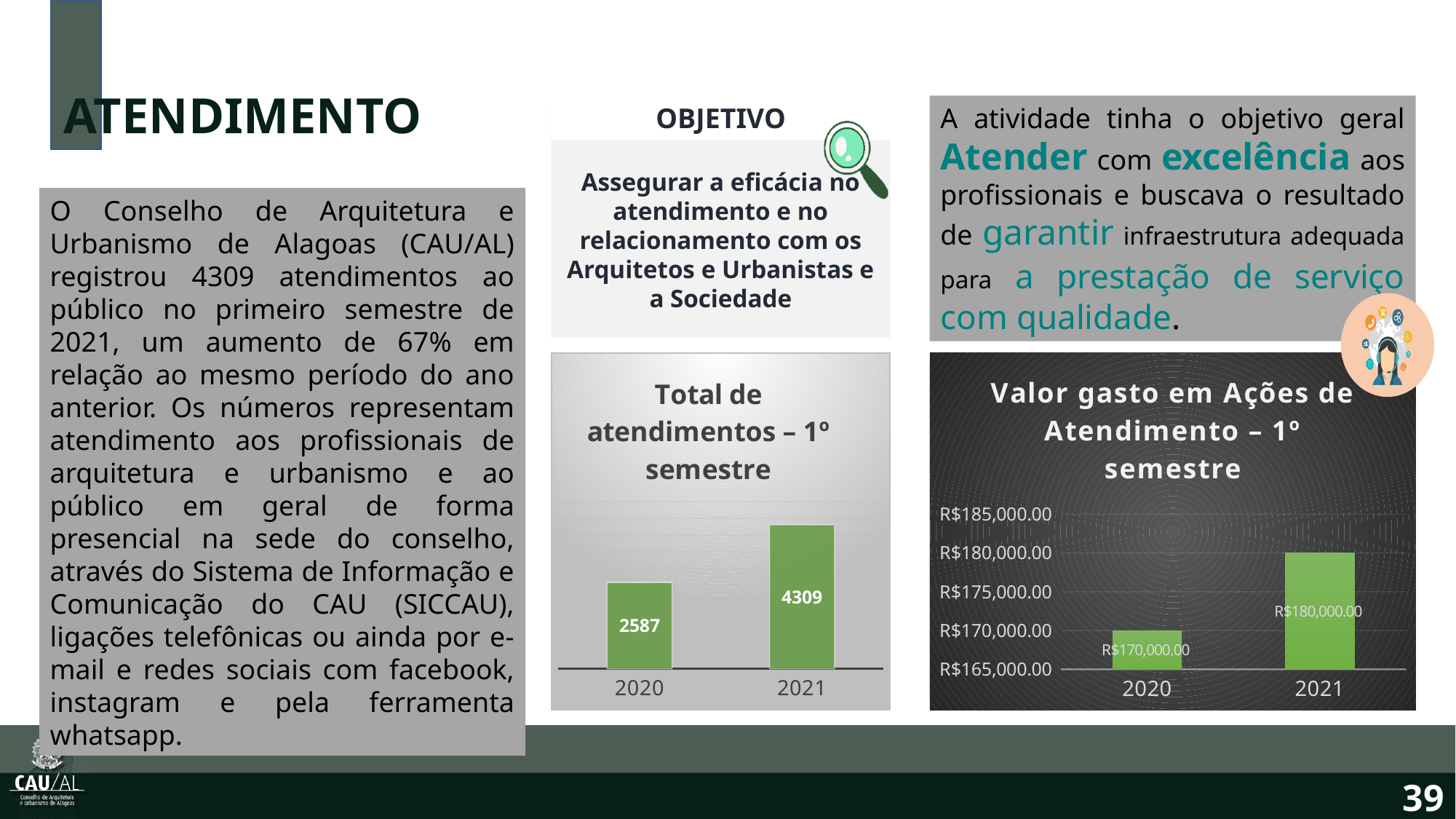
What kind of chart is 'Total de atendimentos – 1º semestre'? bar chart In the 'Total de atendimentos – 1º semestre' chart, how many categories are shown on the x axis? 2 In the 'Valor gasto em Ações de Atendimento – 1º semestre' chart, what is the value for 2020? R$170,000.00 In the 'Valor gasto em Ações de Atendimento – 1º semestre' chart, which year has the lower value? 2020 In the 'Valor gasto em Ações de Atendimento – 1º semestre' chart, do the values rise or fall from 2020 to 2021? rise In the 'Total de atendimentos – 1º semestre' chart, what is the value for 2020? 2587 In the 'Valor gasto em Ações de Atendimento – 1º semestre' chart, what is the value for 2021? R$180,000.00 In the 'Total de atendimentos – 1º semestre' chart, what is the value for 2021? 4309 What is the title of the chart on the dark background at the right of the slide? Valor gasto em Ações de Atendimento – 1º semestre In the 'Total de atendimentos – 1º semestre' chart, what is the difference between the 2021 and 2020 values? 1722 In the 'Valor gasto em Ações de Atendimento – 1º semestre' chart, what is the difference between the 2021 and 2020 values? R$10,000.00 In the 'Total de atendimentos – 1º semestre' chart, which year has the higher value? 2021